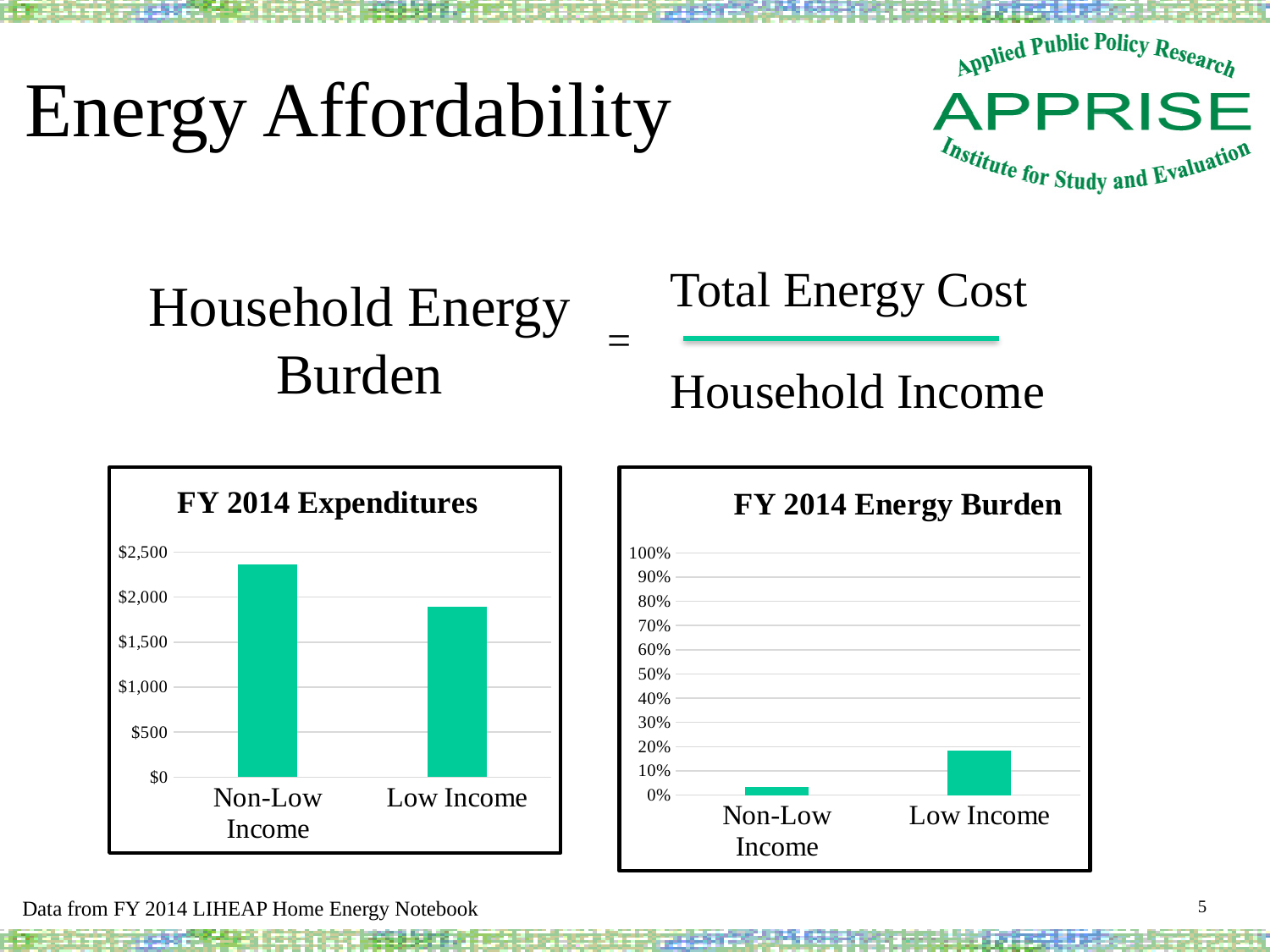
In the FY 2014 Expenditures chart, which category has the lowest value? Low Income In the FY 2014 Energy Burden chart, which category has the highest value? Low Income In the FY 2014 Energy Burden chart, which is larger, the value for Non-Low Income or Low Income? Low Income In the FY 2014 Expenditures chart, is the value for Non-Low Income greater or less than $2,000? greater In the FY 2014 Expenditures chart, is the value for Low Income greater or less than $1,500? greater In the FY 2014 Energy Burden chart, which category has the lowest value? Non-Low Income In the FY 2014 Energy Burden chart, is the value for Non-Low Income greater or less than 10%? less What kind of chart is the FY 2014 Expenditures chart? bar chart In the FY 2014 Expenditures chart, which category has the highest value? Non-Low Income What is the title of the chart on the right side of the slide? FY 2014 Energy Burden In the FY 2014 Expenditures chart, how many categories are shown? 2